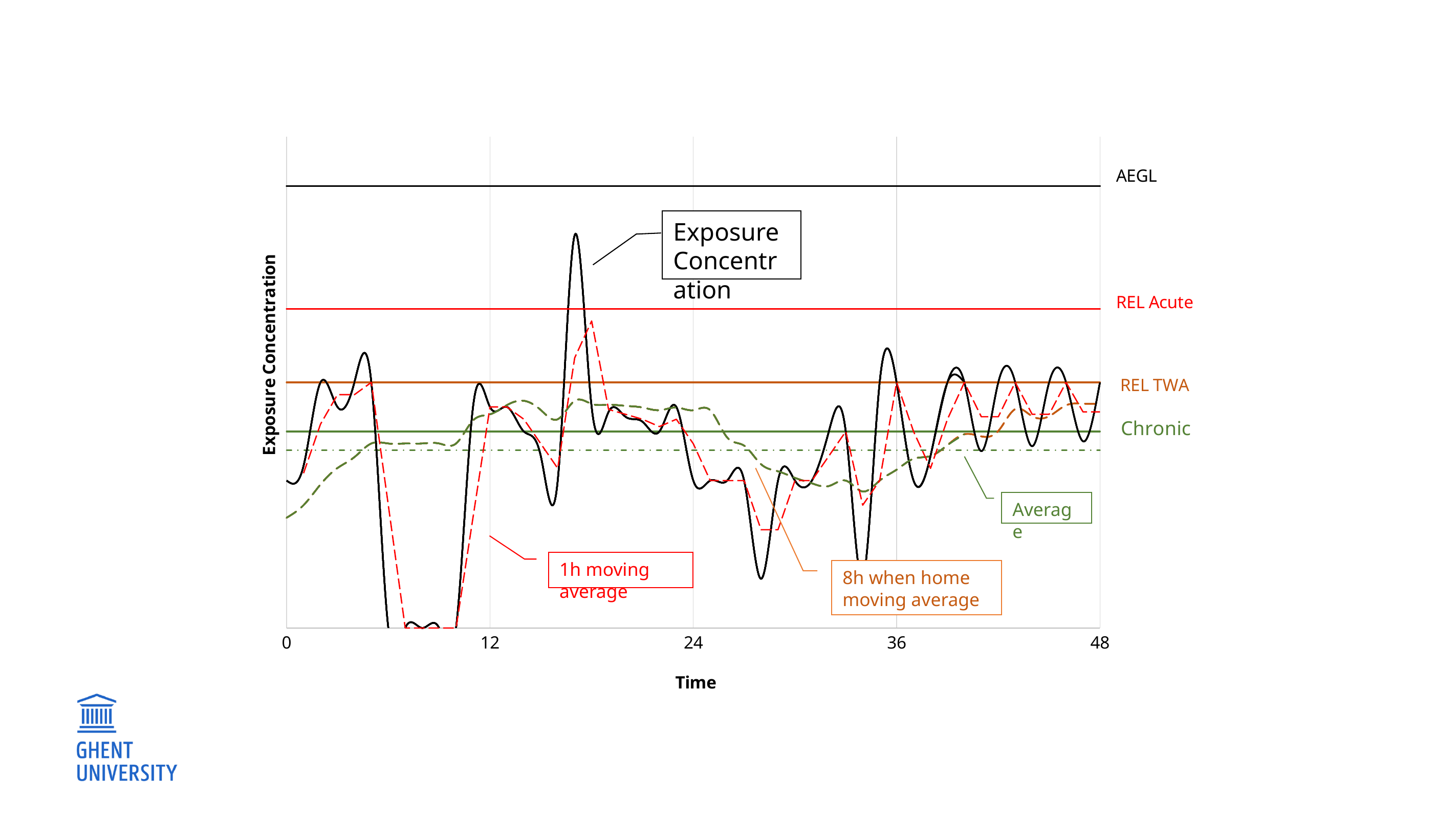
What is the title of the y axis of the chart? Exposure Concentration What is the largest value shown on the x axis of the chart? 48 Does the Exposure Concentration line ever rise above the REL Acute line? Yes Which series is drawn as a solid black line on the chart? Exposure Concentration Which reference line is higher on the chart, REL Acute or REL TWA? REL Acute What kind of chart is shown on the slide? Line chart Does the Exposure Concentration line ever rise above the AEGL line? No Which horizontal reference line is the highest on the chart? AEGL Between time 12 and time 24, does the Exposure Concentration line reach its highest peak of the whole chart? Yes What is the title of the x axis of the chart? Time How many tick labels are shown on the x axis of the chart? 5